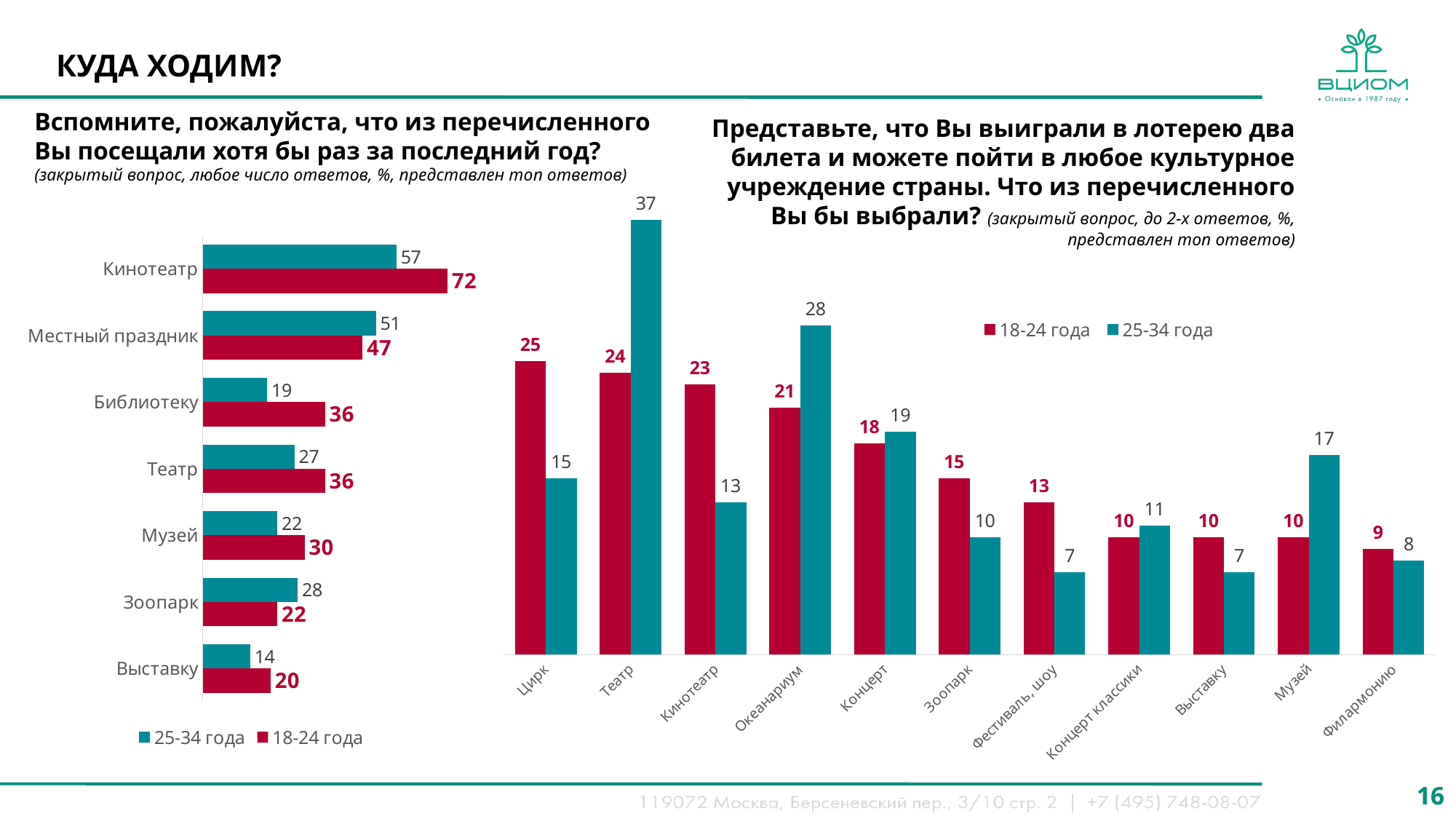
In the right chart (lottery tickets question), which category has the highest value for 18-24 года? Цирк What type of chart is the right chart (lottery tickets question)? Bar chart In the left chart (visited at least once in the last year), how many categories are shown? 7 In the right chart (lottery tickets question), what is the difference between the 25-34 года and 18-24 года values for Океанариум? 7 In the right chart (lottery tickets question), which category has the lowest value for 25-34 года? Фестиваль, шоу and Выставку (both 7) In the left chart (visited at least once in the last year), what is the value for Кинотеатр among 18-24 года? 72 In the left chart (visited at least once in the last year), which is larger for Зоопарк: 25-34 года or 18-24 года? 25-34 года In the left chart (visited at least once in the last year), what is the value for Библиотеку among 25-34 года? 19 In the right chart (lottery tickets question), how many categories are shown on the x axis? 11 In the left chart (visited at least once in the last year), what is the difference between the 18-24 года and 25-34 года values for Библиотеку? 17 In the right chart (lottery tickets question), what is the value for Театр among 25-34 года? 37 In the left chart (visited at least once in the last year), which category has the highest value for 25-34 года? Кинотеатр